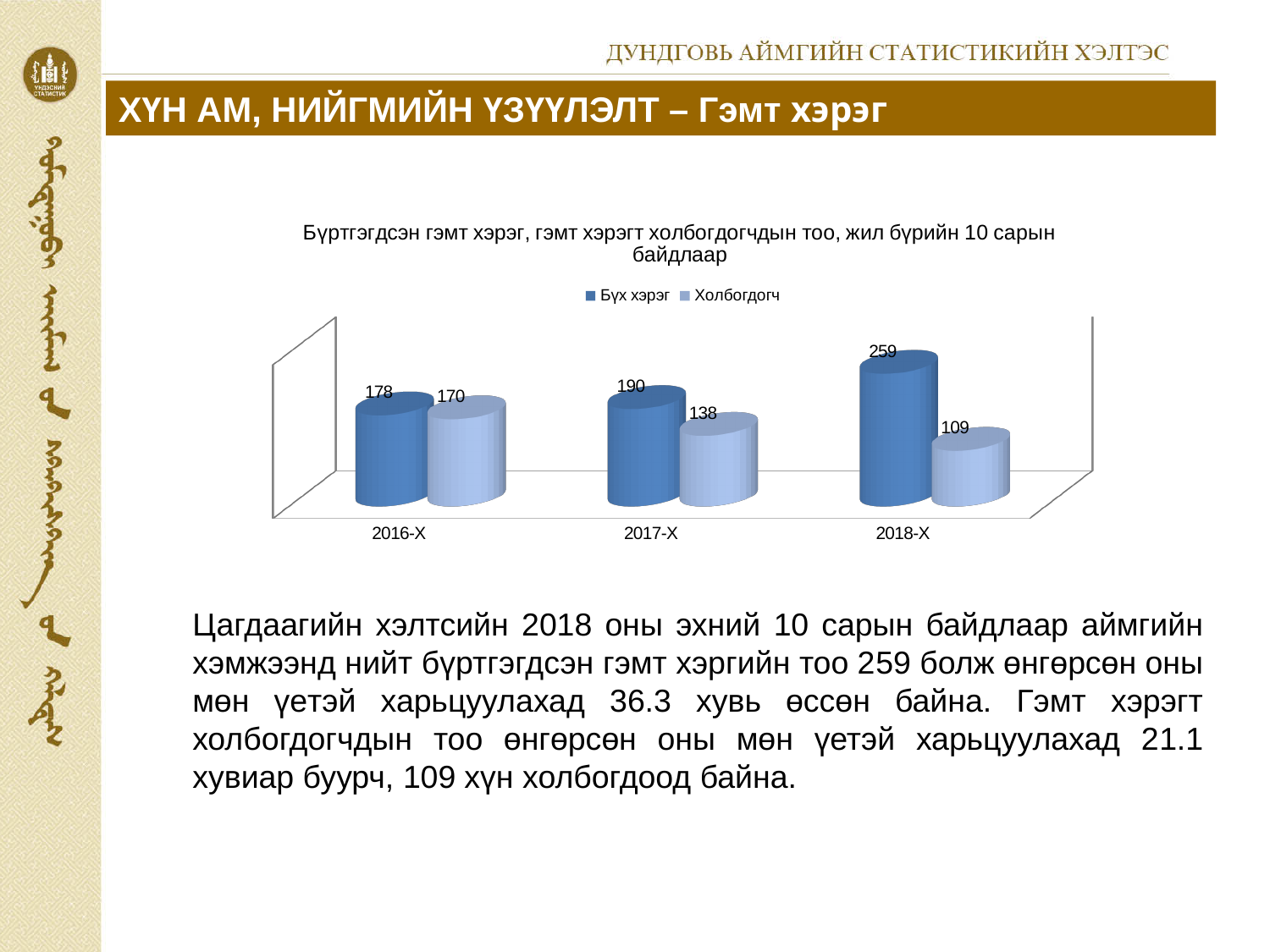
How many categories are shown on the x axis? 3 What is the value of Бүх хэрэг for 2018-X? 259 What kind of chart is shown on the slide? Bar chart What is the value of Бүх хэрэг for 2016-X? 178 What is the difference between Бүх хэрэг and Холбогдогч for 2018-X? 150 Which category has the highest value for Бүх хэрэг? 2018-X Which category has the lowest value for Холбогдогч? 2018-X What is the value of Холбогдогч for 2017-X? 138 How many series does the legend list? 2 Which is larger for 2017-X: Бүх хэрэг or Холбогдогч? Бүх хэрэг Do the values for Холбогдогч rise or fall from 2016-X to 2018-X? Fall What is the value of Холбогдогч for 2018-X? 109